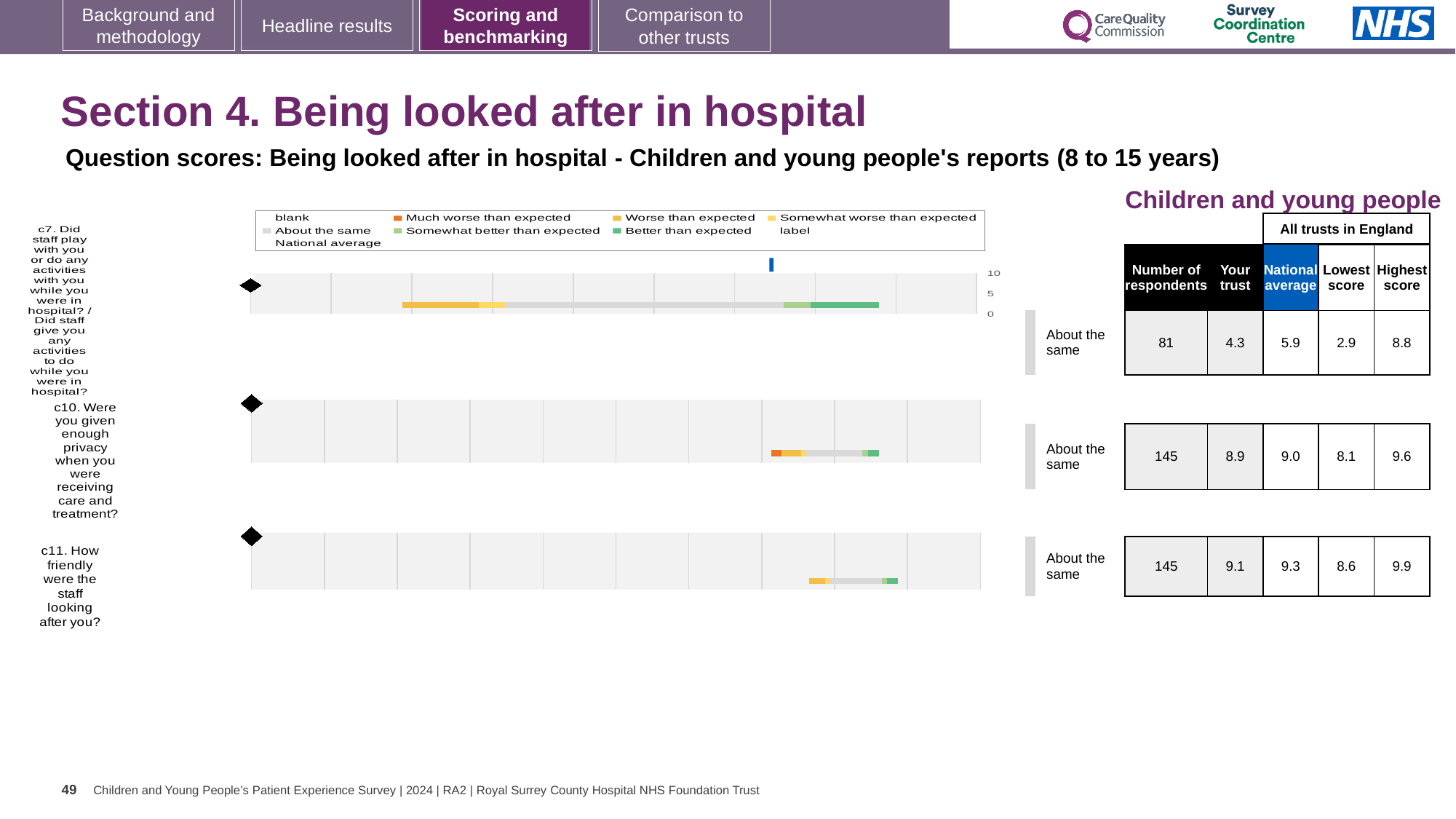
How many survey questions are plotted on this slide? 3 What is the difference between the highest score and the lowest score across all trusts in England for question c7? 5.9 How many respondents answered question c7 (Did staff play with you or do any activities with you while you were in hospital?)? 81 What kind of chart is used to show the question scores on this slide? bar chart What is the 'Your trust' score for question c10 (Were you given enough privacy when you were receiving care and treatment?)? 8.9 What is the difference between the national average and the 'Your trust' score for question c11? 0.2 For question c10, which is larger: the 'Your trust' score or the national average? National average What benchmark category is shown next to each of the three questions on this slide? About the same Is the 'Your trust' score for question c7 greater or less than 5? less Which question has the highest 'Your trust' score? c11. How friendly were the staff looking after you? What is the national average score for question c11 (How friendly were the staff looking after you?)? 9.3 Which question has the lowest 'Your trust' score? c7. Did staff play with you or do any activities with you while you were in hospital?